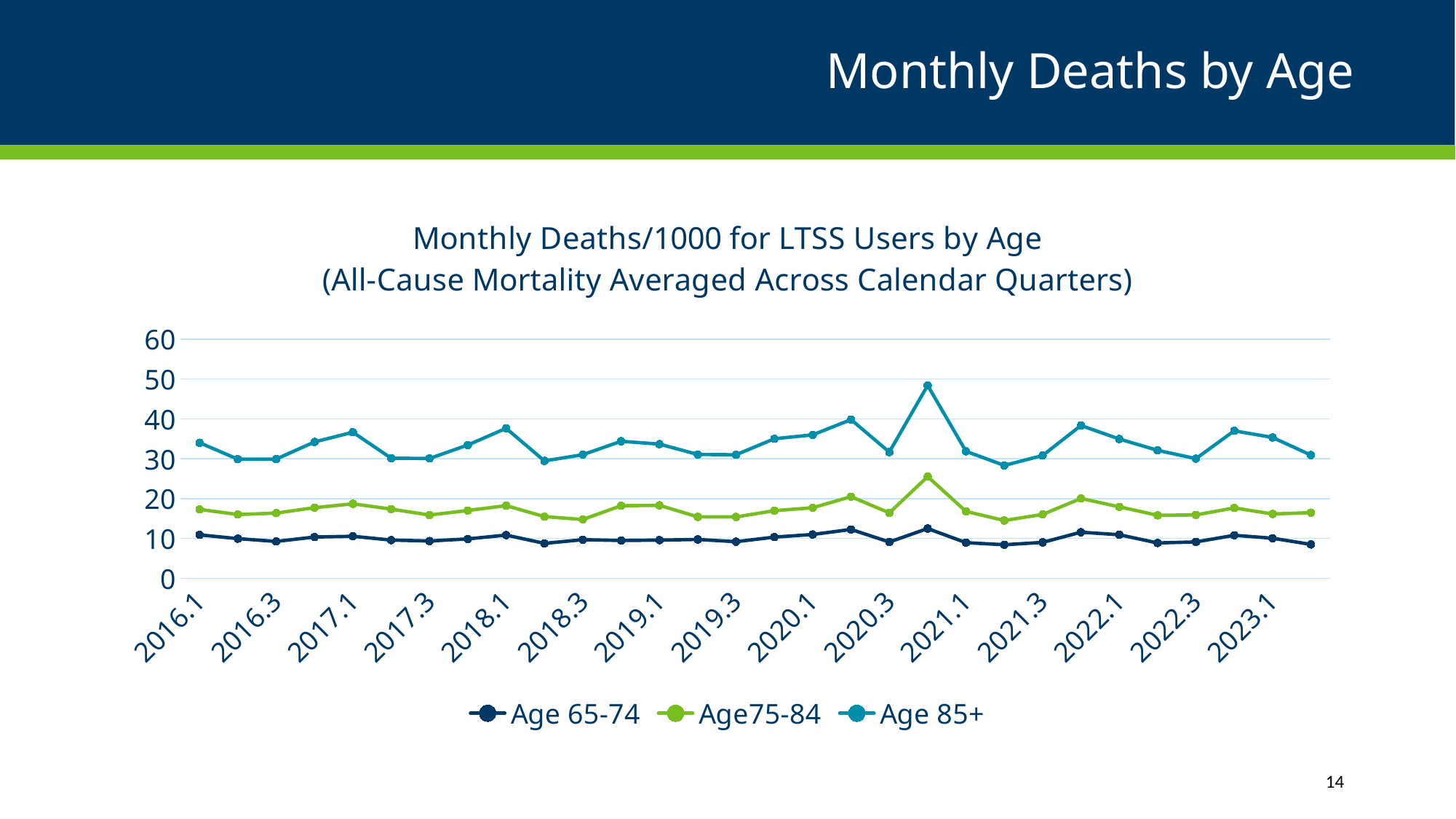
For Age 85+, is the value at 2018.1 larger or smaller than the value at 2018.3? larger What kind of chart is shown on the slide? Line chart Is the highest value for Age 85+ greater or less than 40? greater Which age group has the lowest monthly deaths per 1000 across the whole period? Age 65-74 How many x-axis labels are shown on the chart? 15 Between which two x-axis labels does the Age 85+ line reach its highest peak? 2020.3 and 2021.1 Is the highest value for Age75-84 greater or less than 20? greater Is the value for Age 85+ at 2016.1 greater or less than 30? greater What is the first line of the chart title? Monthly Deaths/1000 for LTSS Users by Age How many series does the legend list? 3 Which age group has the highest monthly deaths per 1000 across the whole period? Age 85+